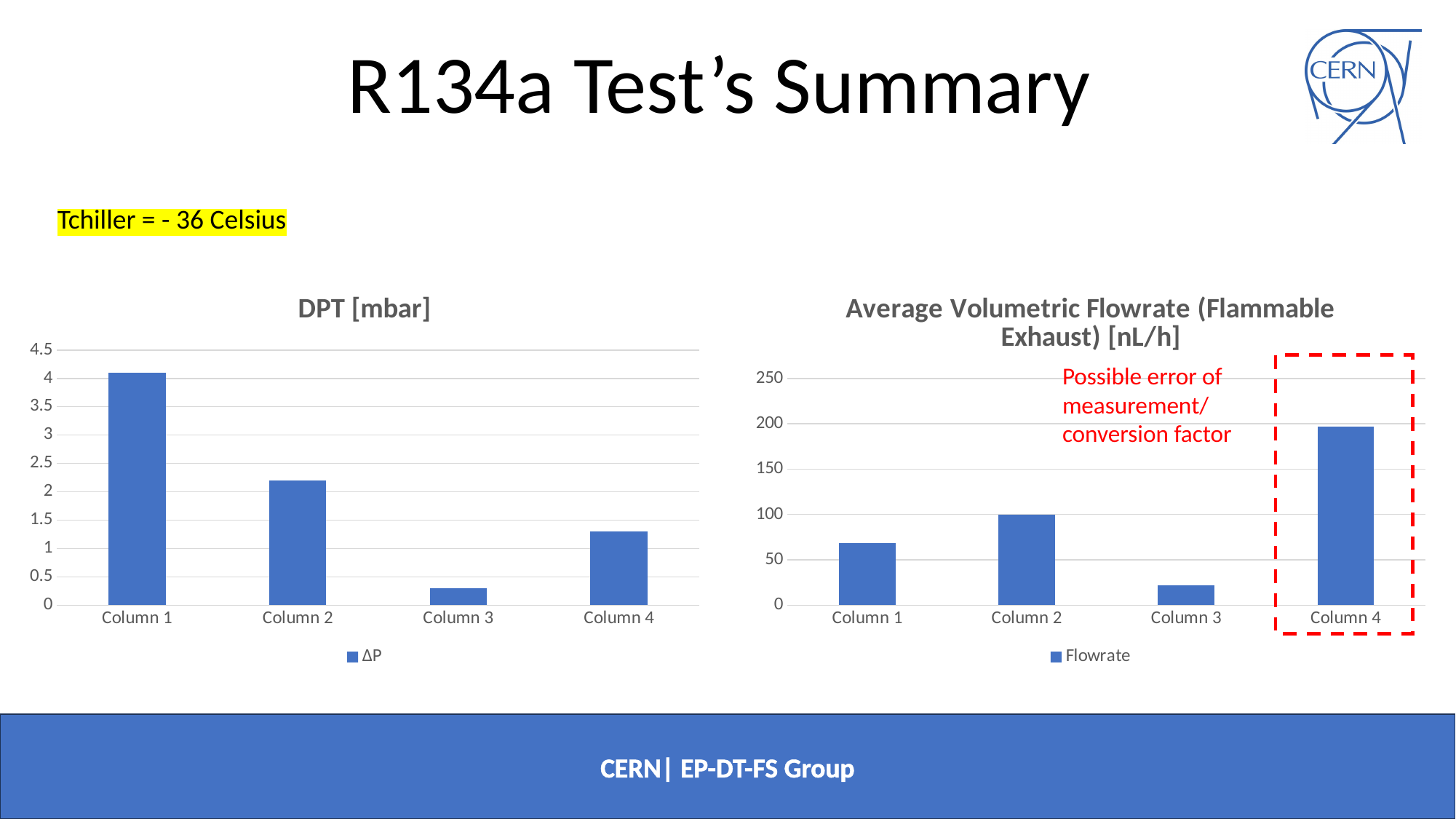
In the Average Volumetric Flowrate chart, which column has the lowest value? Column 3 What series name does the legend of the DPT [mbar] chart show? ΔP In the DPT [mbar] chart, is the value for Column 4 greater or less than 1.5? less In the DPT [mbar] chart, is the value for Column 1 greater or less than 4? greater In the DPT [mbar] chart, which is larger, Column 2 or Column 4? Column 2 What type of chart is the Average Volumetric Flowrate chart? Bar chart How many columns are plotted in the DPT [mbar] chart? 4 In the Average Volumetric Flowrate chart, is the value for Column 1 greater or less than 50? greater In the Average Volumetric Flowrate chart, which column has the highest value? Column 4 In the DPT [mbar] chart, which column has the lowest value? Column 3 In the DPT [mbar] chart, which column has the highest value? Column 1